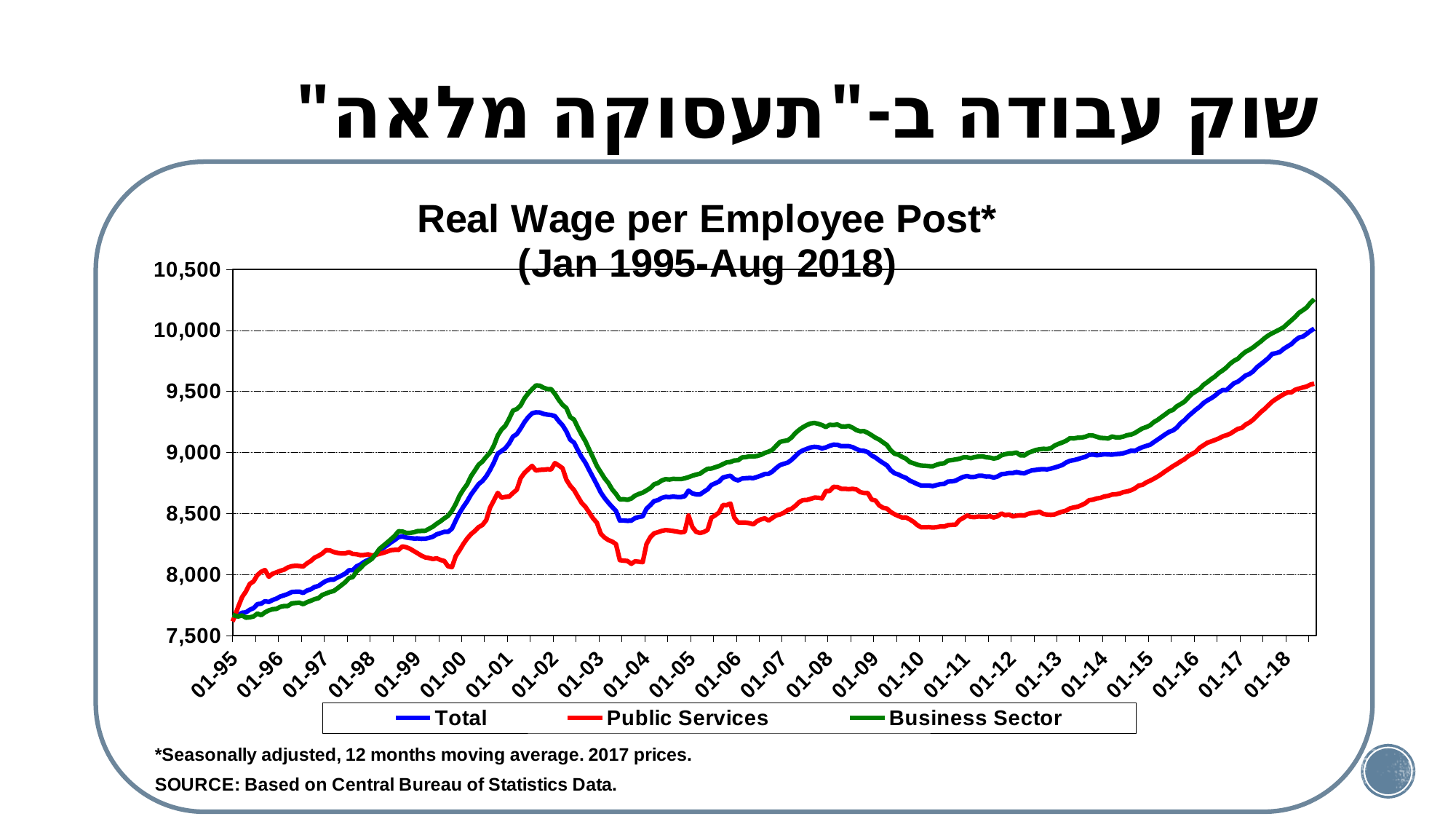
How many series does the legend list? 3 What is the title of the chart? Real Wage per Employee Post* (Jan 1995-Aug 2018) How many year labels are shown on the x axis? 24 Which series has the lowest value at 01-18? Public Services Is the value for Public Services at 01-04 greater or less than 8,500? less Which series has the highest value at 01-18? Business Sector Is the value for Business Sector at the end of the series (Aug 2018) greater or less than 10,000? greater At 01-96, which is larger: Public Services or Total? Public Services Which colour is used for the Total series? Blue What kind of chart is shown on the slide? Line chart Do the values for Total rise or fall between 01-15 and 01-18? Rise Is the value for Total at 01-02 greater or less than 9,000? greater